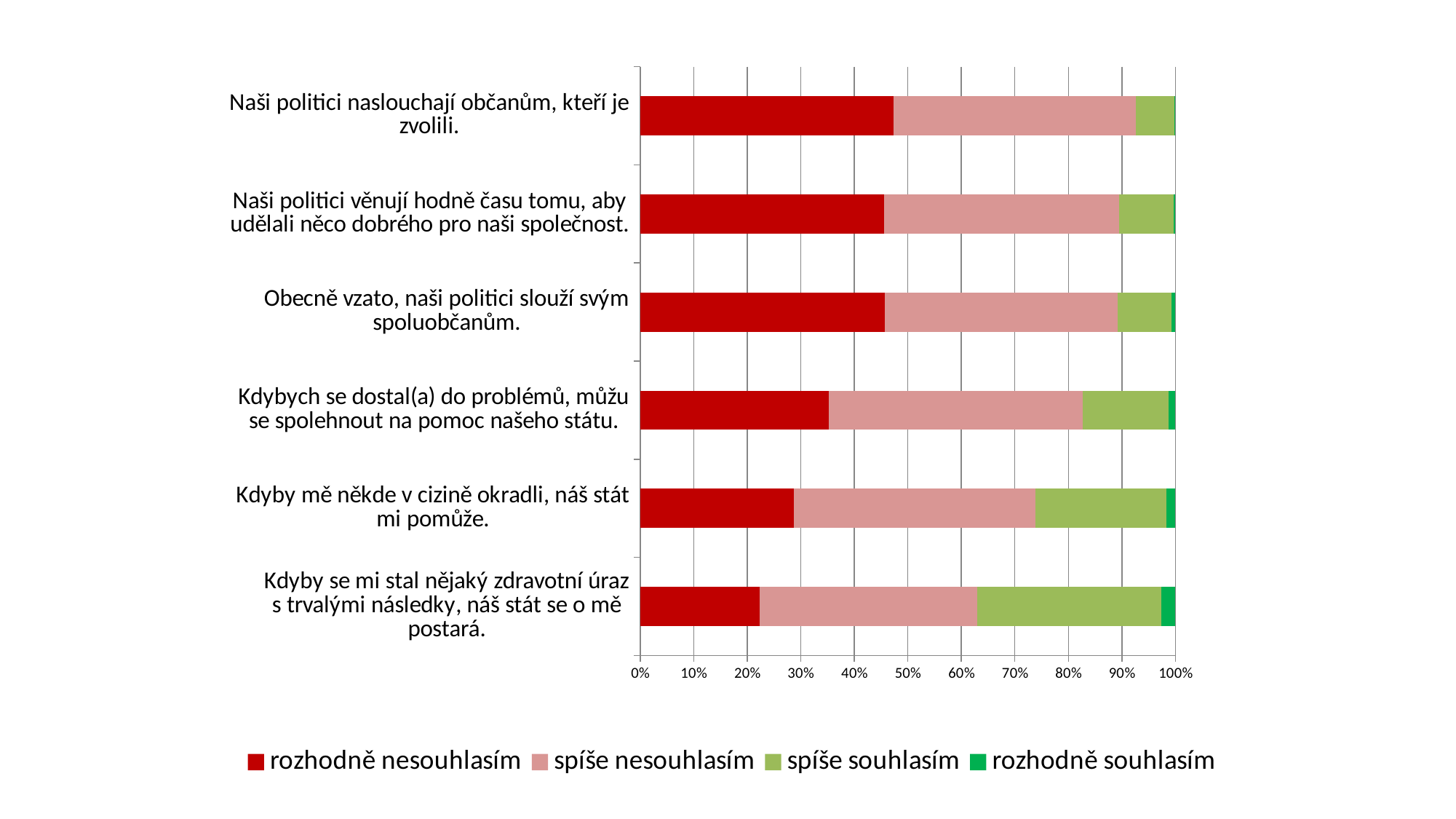
How many statements (categories) are plotted on the chart? 6 Which statement has the largest 'spíše souhlasím' segment? Kdyby se mi stal nějaký zdravotní úraz s trvalými následky, náš stát se o mě postará. Which statement has the smallest 'rozhodně nesouhlasím' segment? Kdyby se mi stal nějaký zdravotní úraz s trvalými následky, náš stát se o mě postará. How many series does the legend list? 4 Which has the larger 'rozhodně nesouhlasím' share: 'Kdybych se dostal(a) do problémů, můžu se spolehnout na pomoc našeho státu.' or 'Kdyby mě někde v cizině okradli, náš stát mi pomůže.'? Kdybych se dostal(a) do problémů, můžu se spolehnout na pomoc našeho státu. Is the 'rozhodně nesouhlasím' share for 'Naši politici naslouchají občanům, kteří je zvolili.' greater or less than 40%? greater Is the 'rozhodně nesouhlasím' share for 'Kdyby se mi stal nějaký zdravotní úraz s trvalými následky, náš stát se o mě postará.' greater or less than 30%? less Which series is shown in bright green in the legend? rozhodně souhlasím What kind of chart is shown on the slide? Stacked bar chart Is the 'rozhodně nesouhlasím' share for 'Kdyby mě někde v cizině okradli, náš stát mi pomůže.' greater or less than 40%? less Which has the larger 'spíše souhlasím' share: 'Naši politici naslouchají občanům, kteří je zvolili.' or 'Kdyby se mi stal nějaký zdravotní úraz s trvalými následky, náš stát se o mě postará.'? Kdyby se mi stal nějaký zdravotní úraz s trvalými následky, náš stát se o mě postará. What is the highest value shown on the horizontal axis? 100%